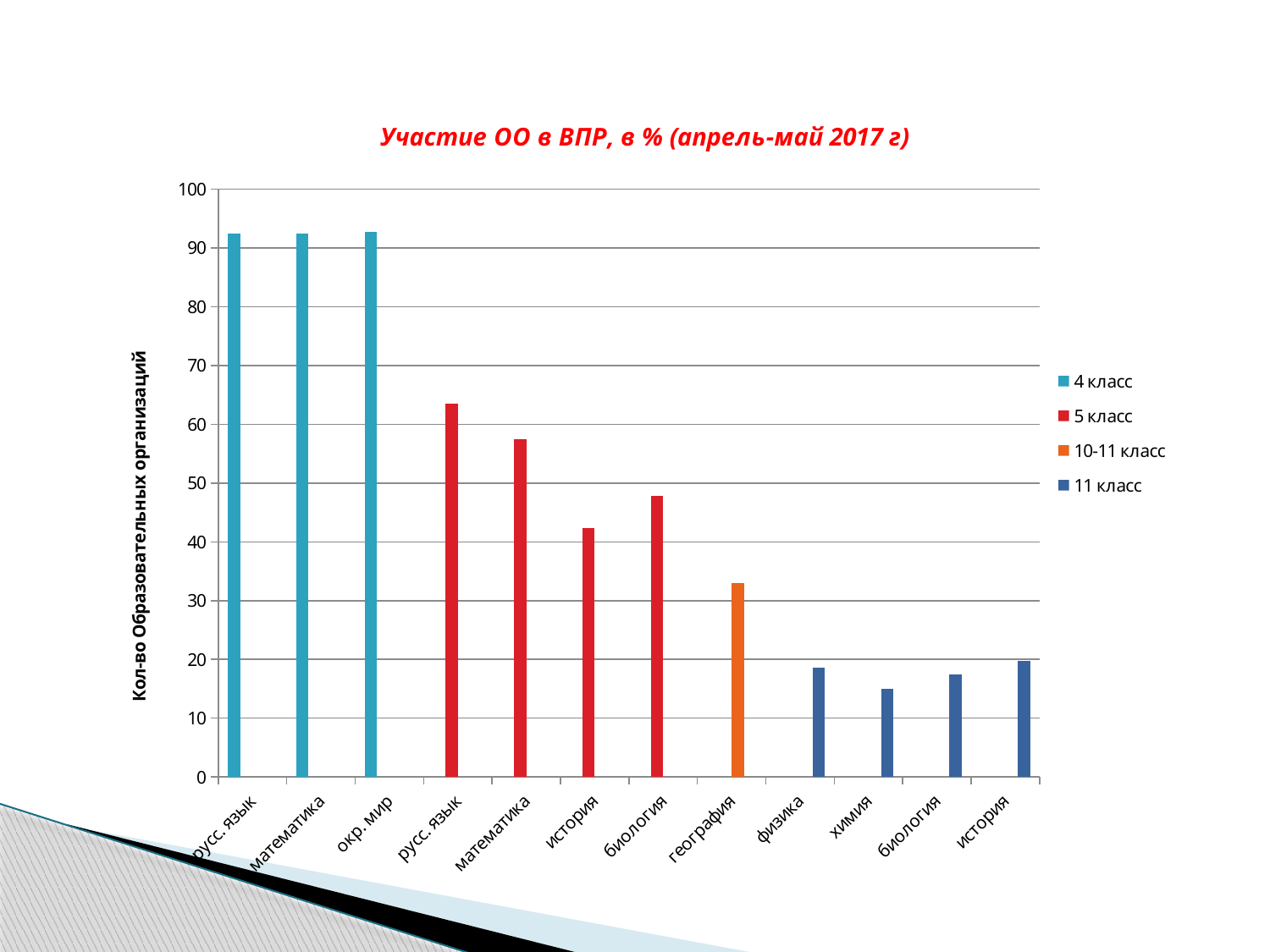
What kind of chart is shown on the slide? bar chart Is the value for русс. язык in the 5 класс series greater or less than 60? greater What is the label of the vertical axis? Кол-во Образовательных организаций Which of the 11 класс bars is the lowest? химия Is the value for география (10-11 класс) greater or less than 30? greater Is the value for история in the 5 класс series greater or less than 50? less How many bars are plotted in the chart? 12 What is the title of the chart? Участие ОО в ВПР, в % (апрель-май 2017 г) Do the values generally rise or fall from left to right across the chart? fall Which is larger: русс. язык or математика in the 5 класс series? русс. язык How many series does the legend list? 4